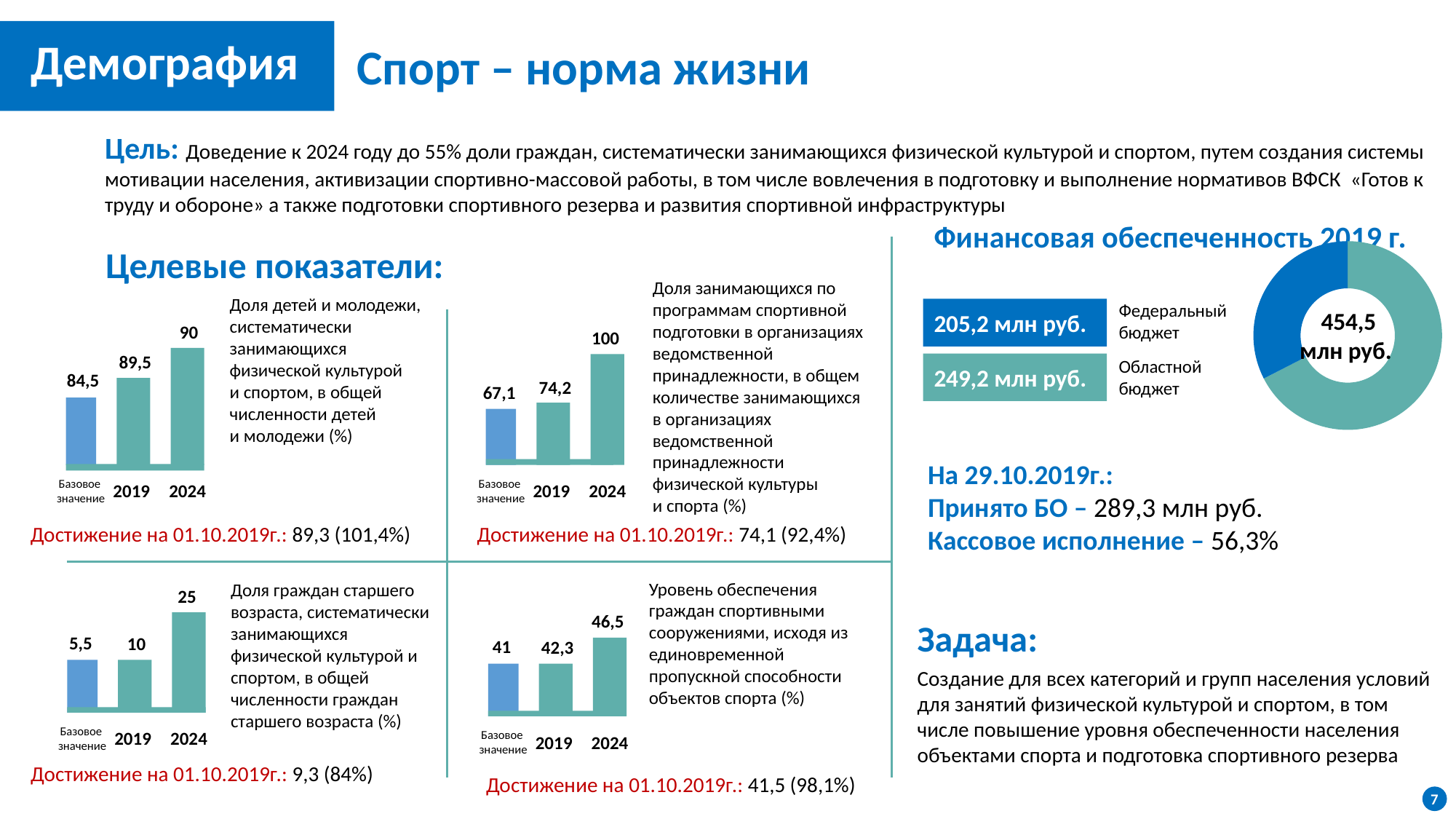
In the bottom-left bar chart (share of older citizens regularly engaged in physical culture and sport), what is the value for 2019? 10 In the bottom-middle bar chart (level of provision of citizens with sports facilities), what is the value for 2024? 46,5 In the bottom-left bar chart (share of older citizens), what is the difference between the 2024 value and the 2019 value? 15 In the top-middle bar chart (share engaged in sports training programmes in departmental organisations), what is the value for 2024? 100 In the donut chart 'Финансовая обеспеченность 2019 г.', what is the value for the federal budget (Федеральный бюджет)? 205,2 млн руб. In the donut chart 'Финансовая обеспеченность 2019 г.', which is larger: the federal budget or the regional budget (Областной бюджет)? Областной бюджет How many bars does the bottom-middle bar chart (level of provision with sports facilities) have? 3 In the top-left bar chart (share of children and youth regularly engaged in physical culture and sport), what is the value for 2024? 90 In the bottom-middle bar chart (level of provision with sports facilities), do the values rise or fall from the base value to 2024? rise In the top-left bar chart (share of children and youth), what is the difference between the 2019 value and the base value? 5 In the top-middle bar chart (share engaged in sports training programmes), which category has the lowest value? Базовое значение In the top-left bar chart (share of children and youth), what is the base value (Базовое значение)? 84,5